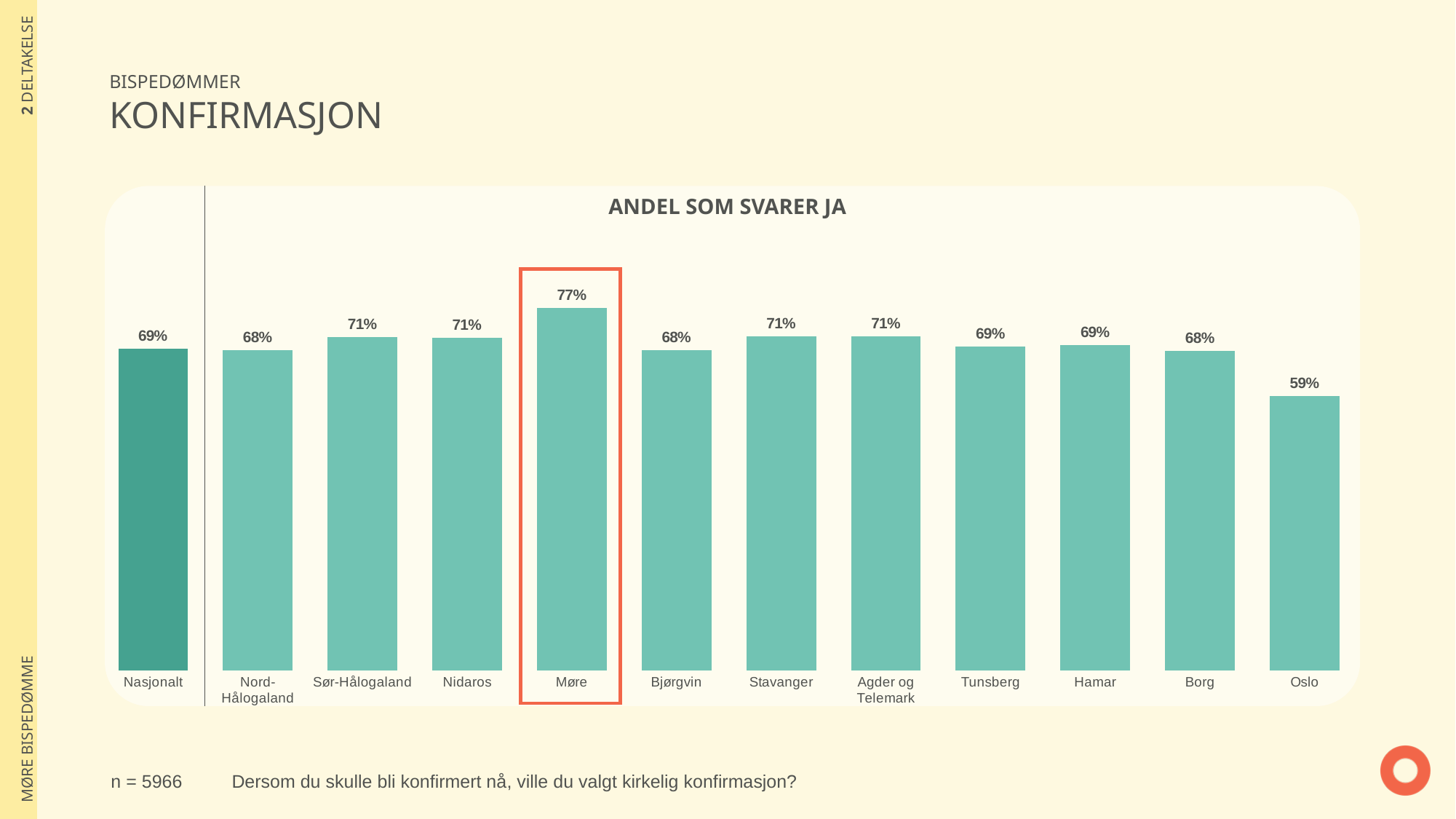
Which is larger, the value for Stavanger or the value for Bjørgvin? Stavanger Which category has the highest value? Møre What is the value for Møre? 77% Which category has the lowest value? Oslo What is the value for Oslo? 59% What kind of chart is shown on the slide? Bar chart What is the difference between the values for Møre and Oslo? 18% What is the value for Sør-Hålogaland? 71% What is the difference between the values for Nidaros and Borg? 3% How many categories are shown in the chart? 12 What is the value for Nasjonalt? 69% What is the title of the chart? ANDEL SOM SVARER JA